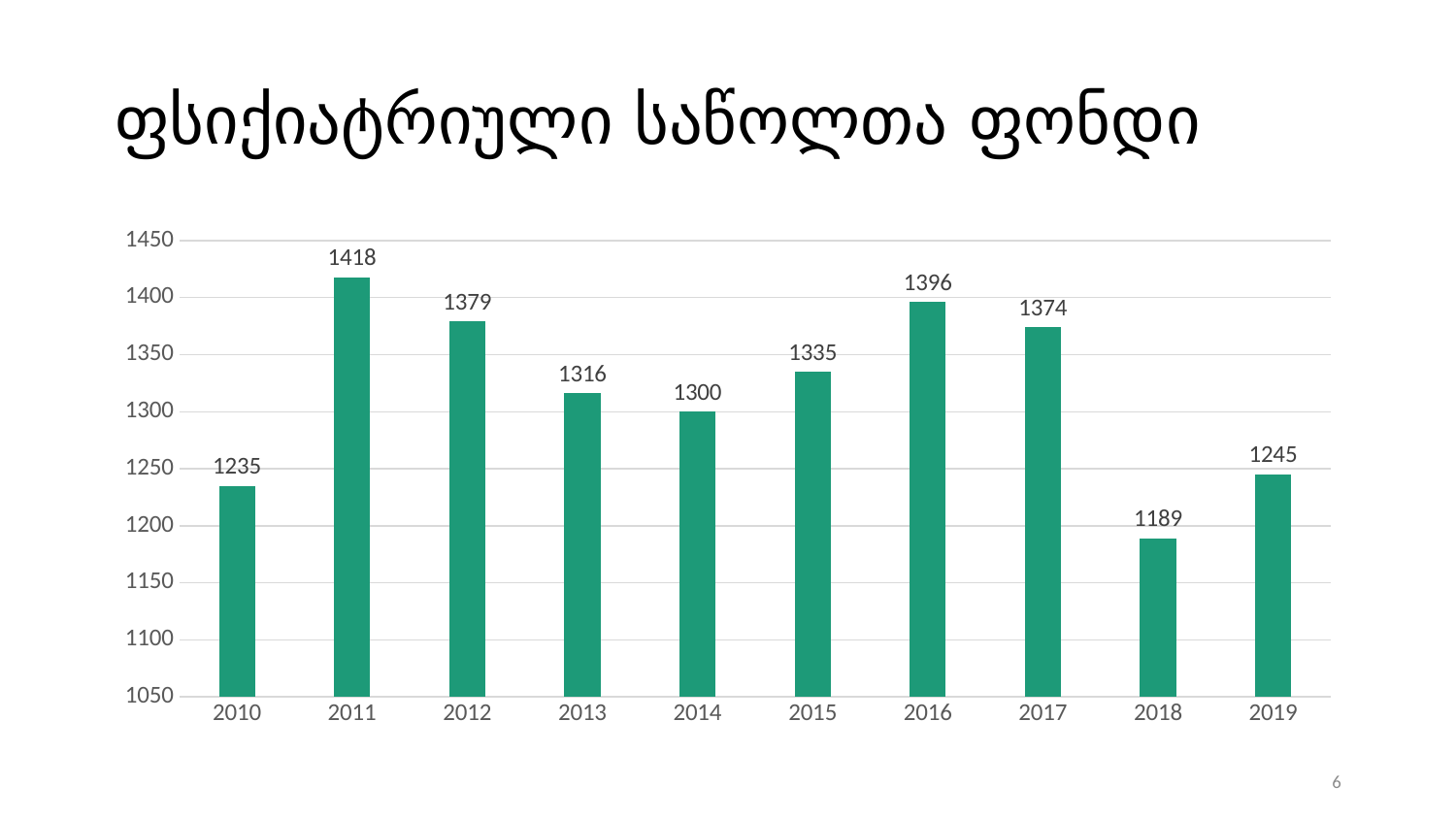
Which year has the lowest value? 2018 What is the difference between the values for 2011 and 2018? 229 Do the values rise or fall from 2016 to 2018? fall What is the value for 2014? 1300 Which is larger, the value for 2012 or the value for 2017? 2012 What is the value for 2018? 1189 What is the value for 2011? 1418 How many years are shown on the x axis? 10 What is the difference between the values for 2016 and 2017? 22 Is the value for 2019 greater or less than 1300? less What kind of chart is shown on the slide? bar chart Which year has the highest value? 2011